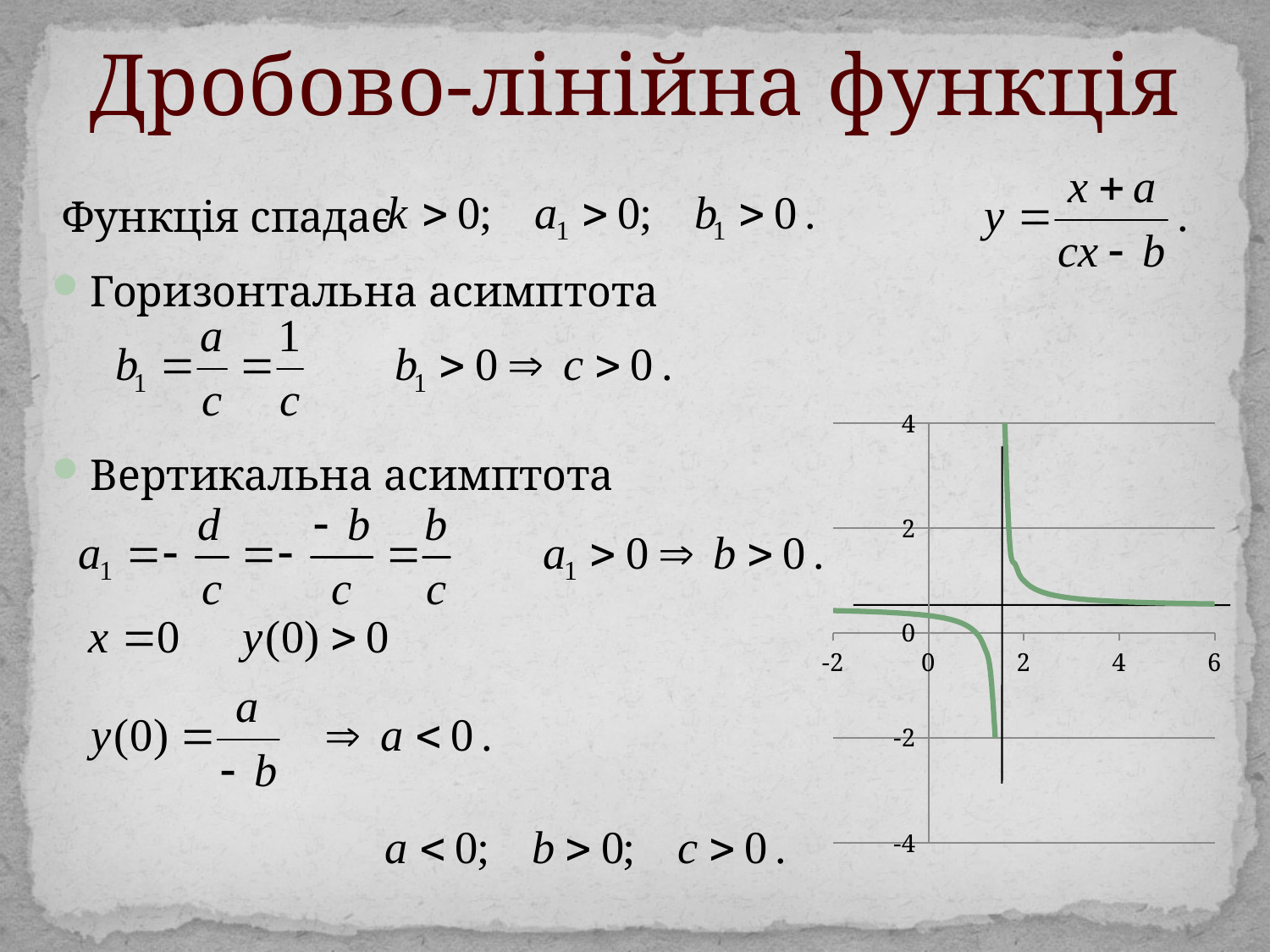
Along the right-hand branch of the curve, do the values rise or fall as x increases from 2 to 6? fall Along the left-hand branch of the curve, do the values rise or fall as x increases from -2 to 1? fall How many tick labels are shown on the x axis of the chart? 5 What is the highest value labelled on the y axis of the chart? 4 Is the value of the curve at x = 1 greater or less than -4? greater Is the value of the curve at x = 4 greater or less than 2? less What colour is the curve plotted on the chart? green What kind of chart is shown on the slide? line chart Is the value of the curve at x = 6 greater or less than 2? less